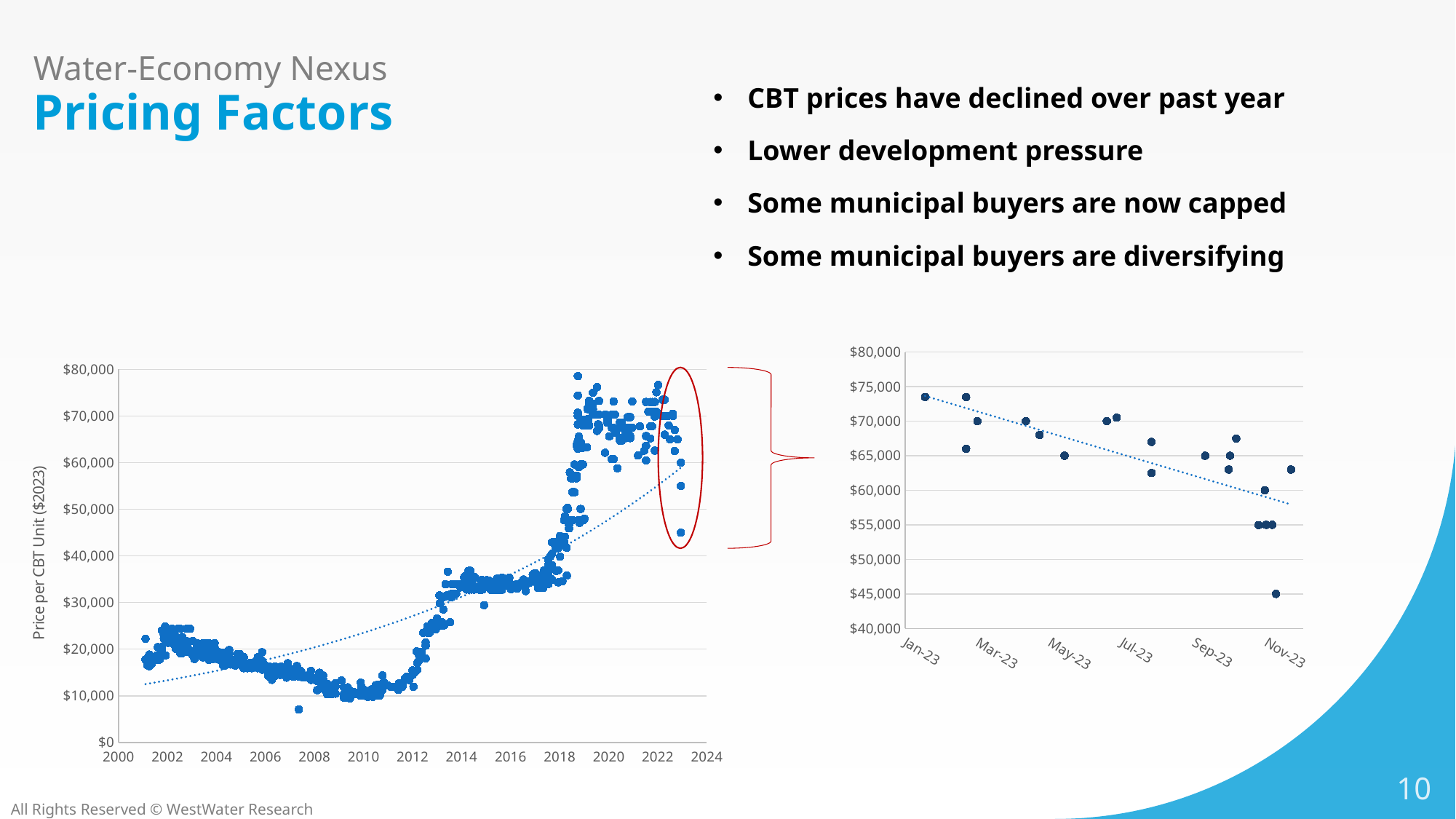
On the left chart, are the values plotted in 2020 greater or less than $50,000? greater On the right chart, what is the first label shown on the x axis? Jan-23 On the right chart, is the value plotted at Jan-23 greater or less than $70,000? greater What kind of chart is the right chart (Jan-23 to Nov-23)? scatter chart On the right chart, is the lowest point plotted near Nov-23 greater or less than $50,000? less On the left chart, what is the label of the y axis? Price per CBT Unit ($2023) What kind of chart is the left chart (Price per CBT Unit)? scatter chart On the left chart, do the prices rise or fall between 2002 and 2009? fall On the right chart, does the dotted trend line rise or fall from Jan-23 to Nov-23? fall On the left chart, do the prices rise or fall between 2010 and 2018? rise